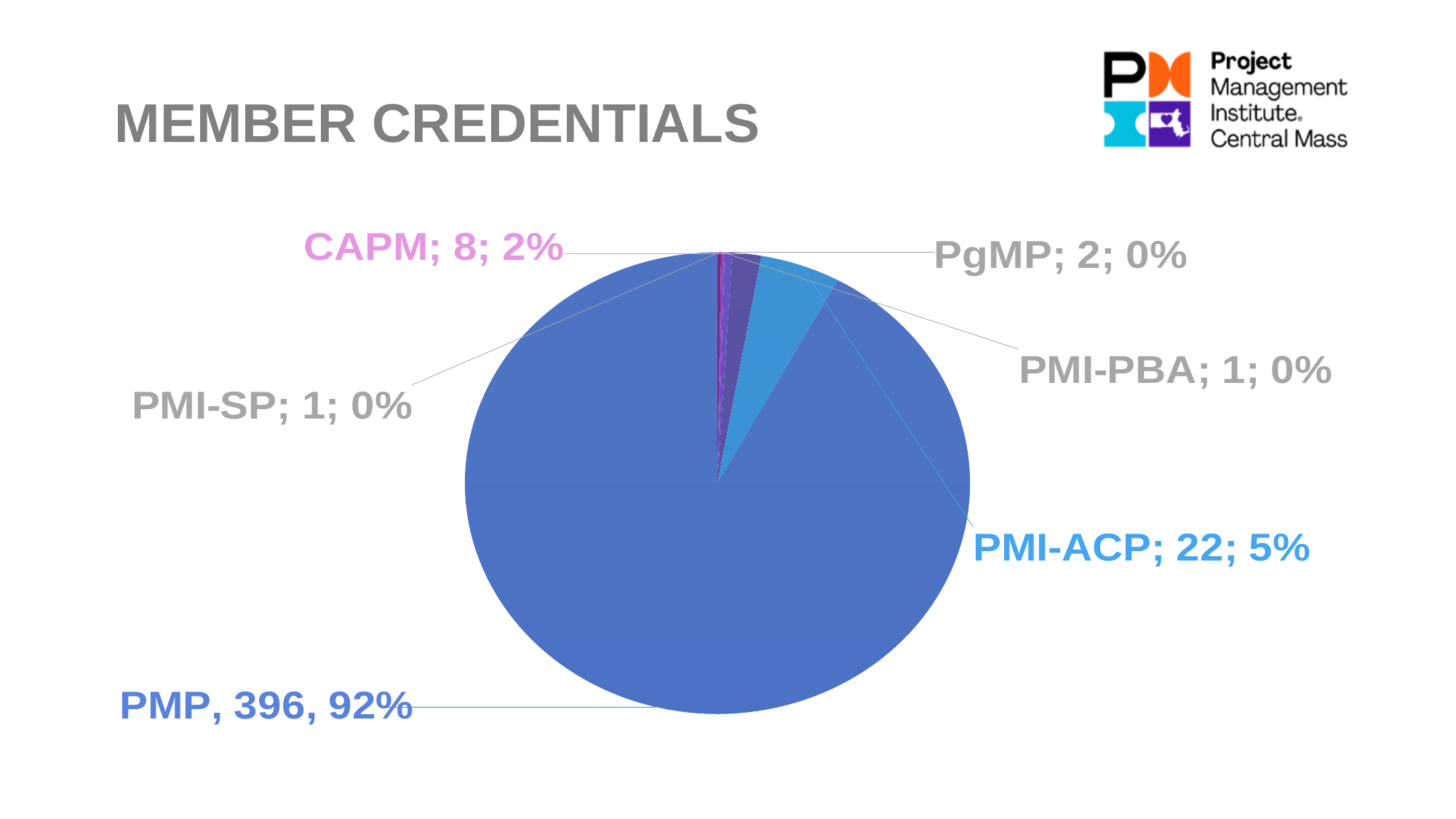
Which is larger, the PMI-ACP count or the PgMP count? PMI-ACP What percentage of the pie is CAPM? 2% What is the difference between the PMP count and the PMI-ACP count? 374 Which credential has the largest slice of the pie? PMP What is the title of the slide containing the chart? MEMBER CREDENTIALS How many members hold the PMI-ACP credential? 22 What kind of chart is shown on the slide? pie chart How many members hold the PMP credential? 396 How many credential categories are shown in the pie chart? 6 What is the difference between the PMI-ACP count and the CAPM count? 14 What share of the pie does PMP represent? 92% How many members hold the PgMP credential? 2